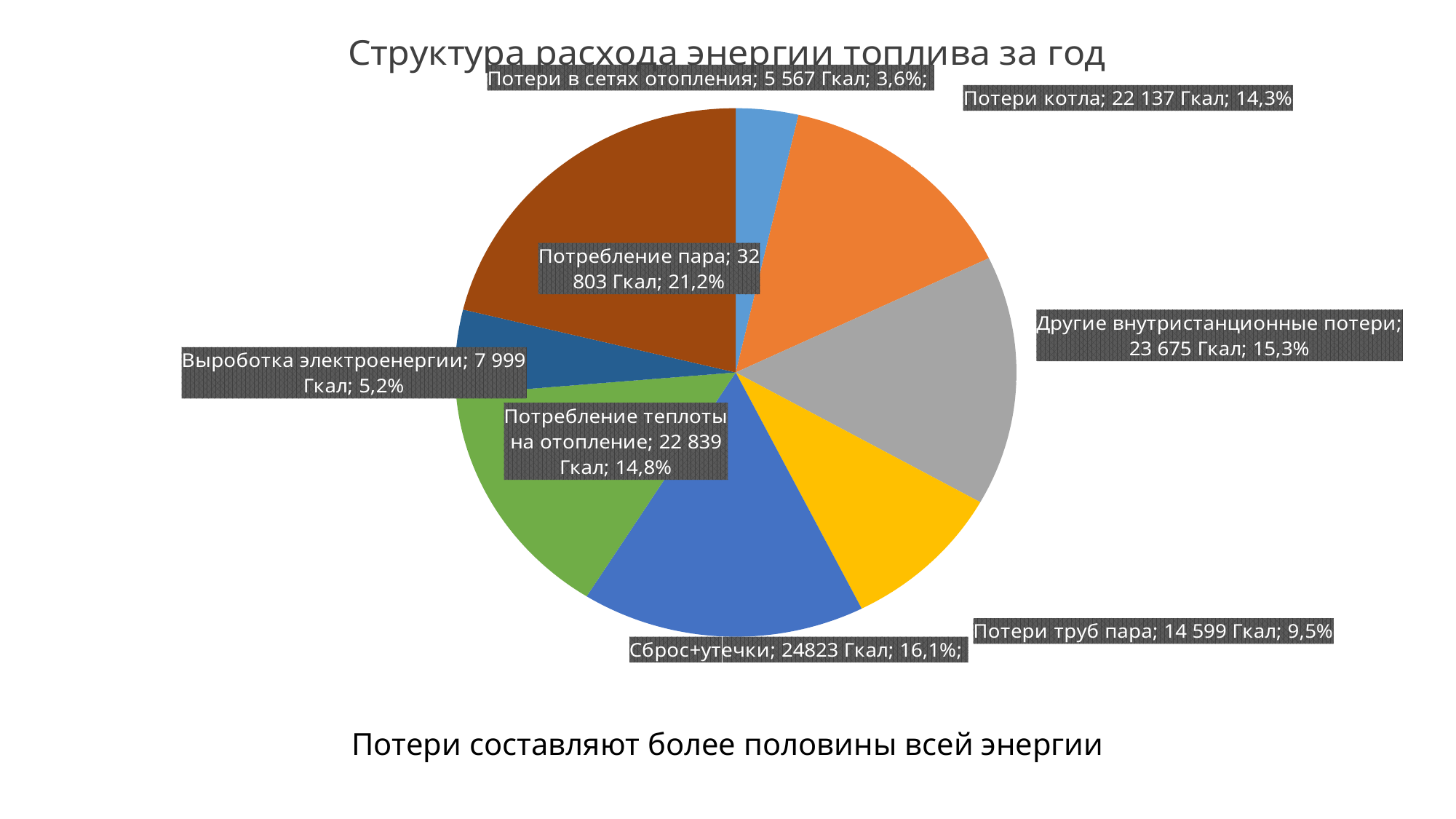
Which category has the largest slice? Потребление пара Which category has the smallest slice? Потери в сетях отопления What share of the pie does Выроботка электроенергии represent? 5,2% What is the title of the chart? Структура расхода энергии топлива за год Which is larger, Другие внутристанционные потери or Потери труб пара? Другие внутристанционные потери How many slices does the pie chart have? 8 What share of the pie does Потребление пара represent? 21,2% What is the value for Сброс+утечки? 24823 Гкал What is the value for Потребление теплоты на отопление? 22 839 Гкал What is the difference in Гкал between Потребление пара and Потери котла? 10 666 Гкал What is the value for Потери котла? 22 137 Гкал What kind of chart is shown on the slide? Pie chart